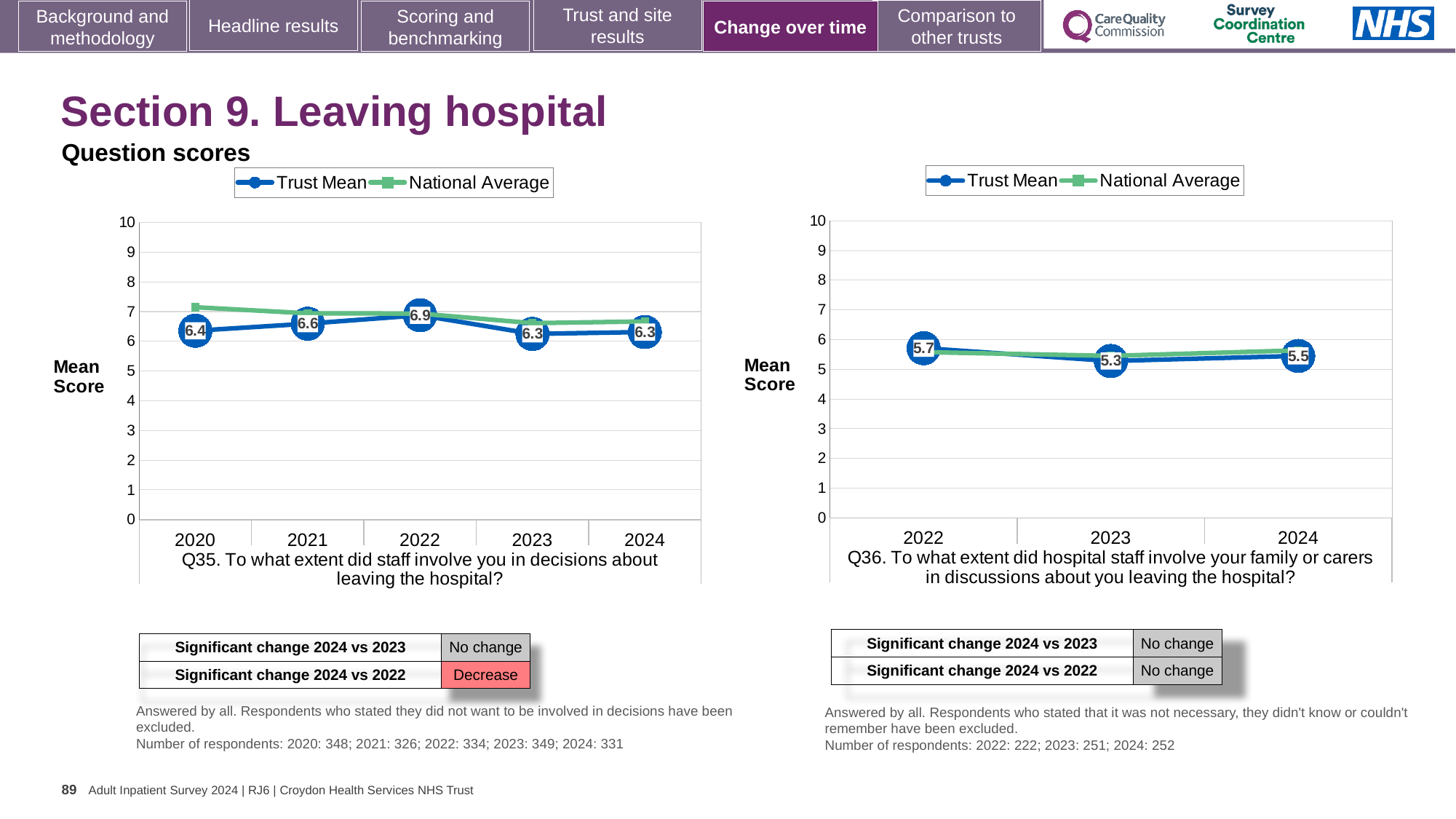
On the Q36 chart (right), which is larger, the Trust Mean score for 2022 or for 2023? 2022 On the Q36 chart (right), which year has the lowest Trust Mean score? 2023 On the Q36 chart (right), what is the Trust Mean score for 2023? 5.3 On the Q35 chart (left), what is the difference between the Trust Mean scores for 2022 and 2024? 0.6 How many series does the legend of the Q35 chart (left) list? 2 On the Q36 chart (right), what is the Trust Mean score for 2024? 5.5 On the Q35 chart (left), what is the Trust Mean score for 2022? 6.9 How many years are plotted on the Q36 chart (right)? 3 On the Q35 chart (left), which year has the highest Trust Mean score? 2022 On the Q35 chart (left), is the National Average for 2020 greater or less than 7? greater What type of chart is used for the Q35 chart (left)? Line chart On the Q35 chart (left), what is the Trust Mean score for 2020? 6.4